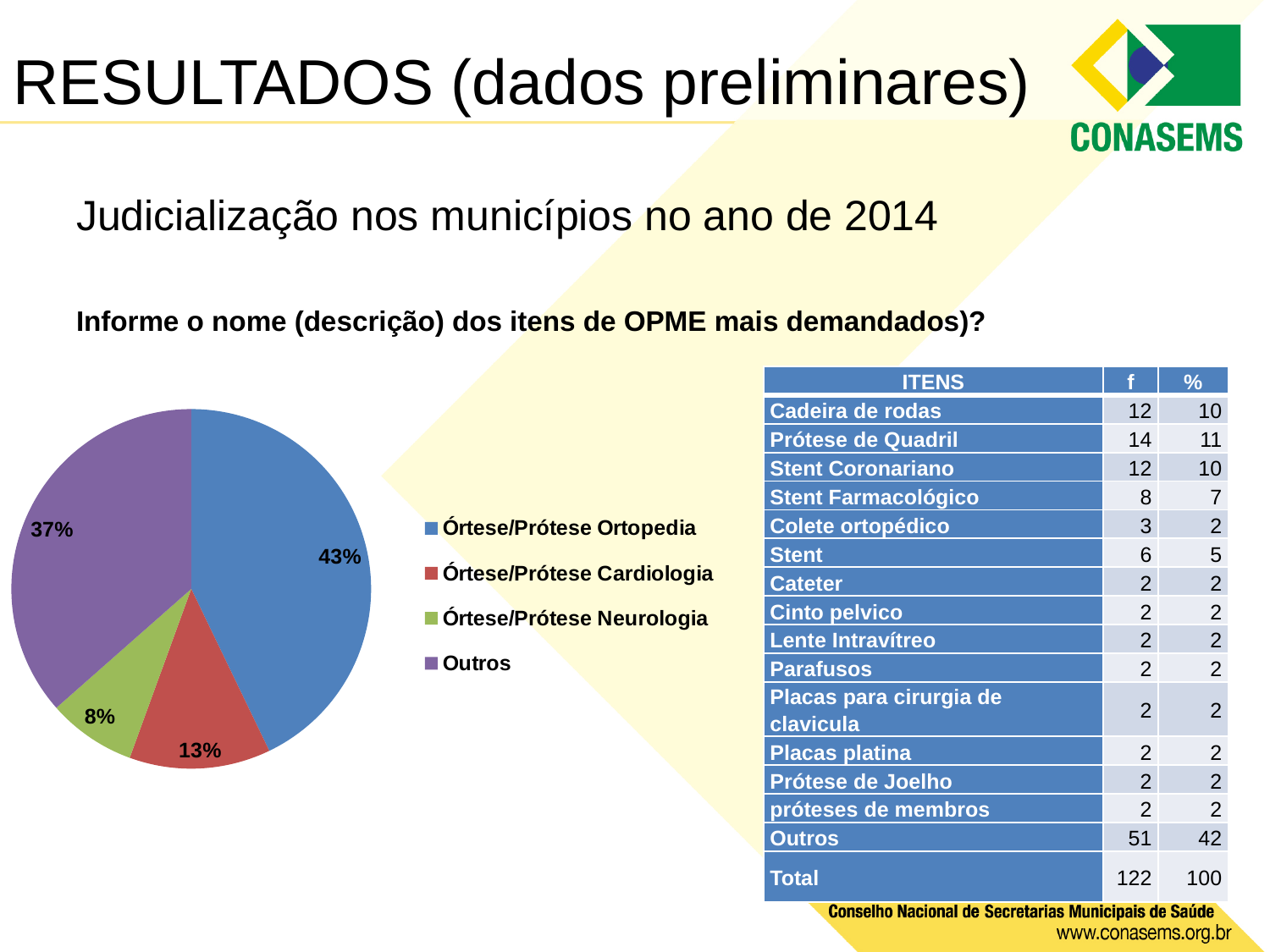
Which category has the largest slice in the pie chart? Órtese/Prótese Ortopedia What colour is the Outros slice in the pie chart? Purple What is the difference in percentage points between the Órtese/Prótese Ortopedia slice and the Outros slice? 6 What share of the pie chart does Órtese/Prótese Ortopedia represent? 43% What share of the pie chart does Órtese/Prótese Cardiologia represent? 13% Which category has the smallest slice in the pie chart? Órtese/Prótese Neurologia How many slices does the pie chart have? 4 What share of the pie chart does Órtese/Prótese Neurologia represent? 8% What is the combined share of the Órtese/Prótese Cardiologia and Órtese/Prótese Neurologia slices? 21% What share of the pie chart does Outros represent? 37% What type of chart is shown on the slide? Pie chart Which slice is larger in the pie chart: Órtese/Prótese Cardiologia or Órtese/Prótese Neurologia? Órtese/Prótese Cardiologia